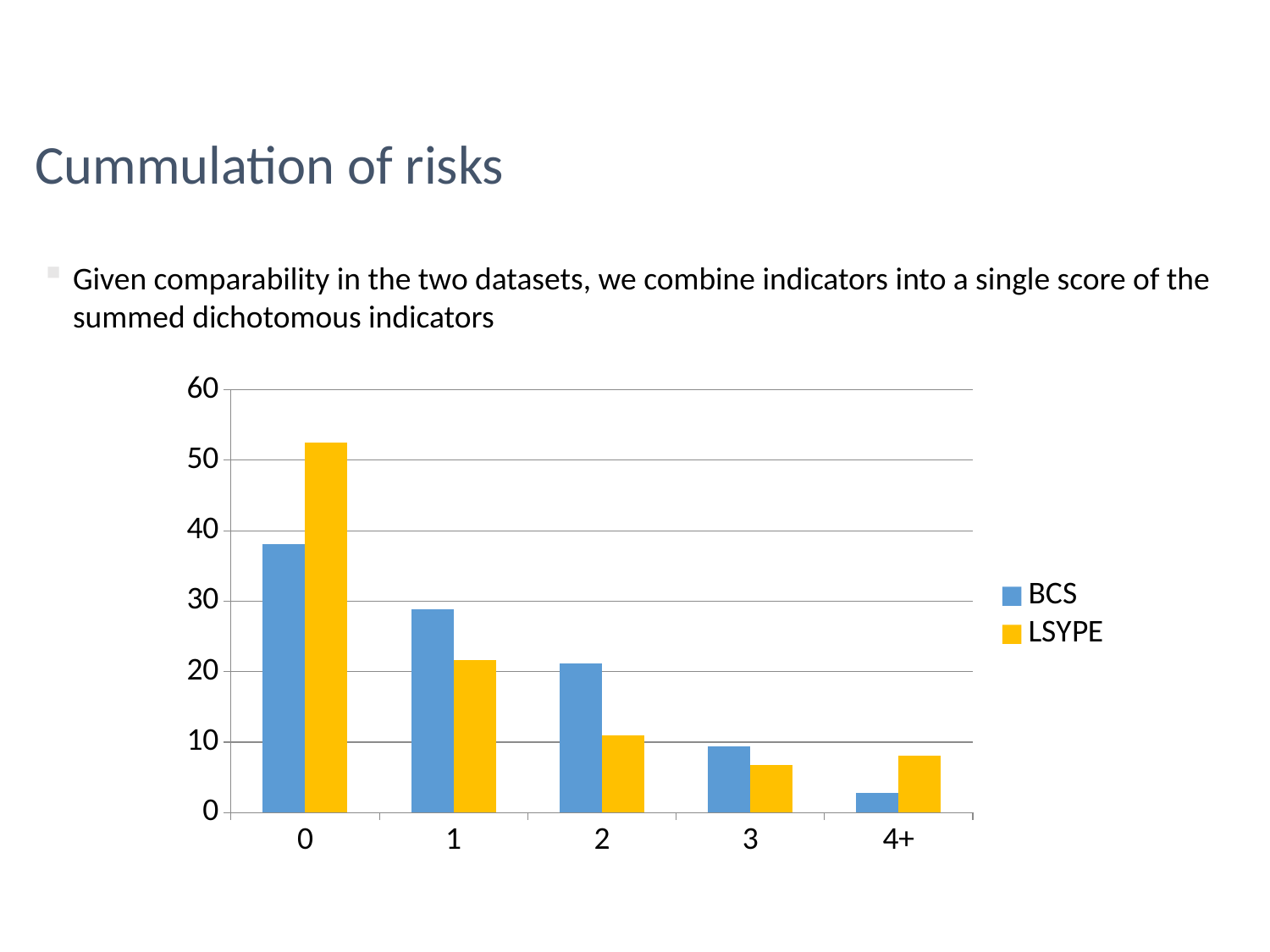
Is the BCS value for category 0 greater or less than 40? less Which is larger for category 4+, the BCS value or the LSYPE value? LSYPE Do the BCS values rise or fall as you move from category 0 to category 4+? fall How many categories are shown on the x axis? 5 Is the LSYPE value for category 0 greater or less than 50? greater Which is larger for category 1, the BCS value or the LSYPE value? BCS What kind of chart is shown on the slide? bar chart Is the LSYPE value for category 2 greater or less than 10? greater How many series does the legend list? 2 Which category has the highest LSYPE value? 0 Which category has the lowest BCS value? 4+